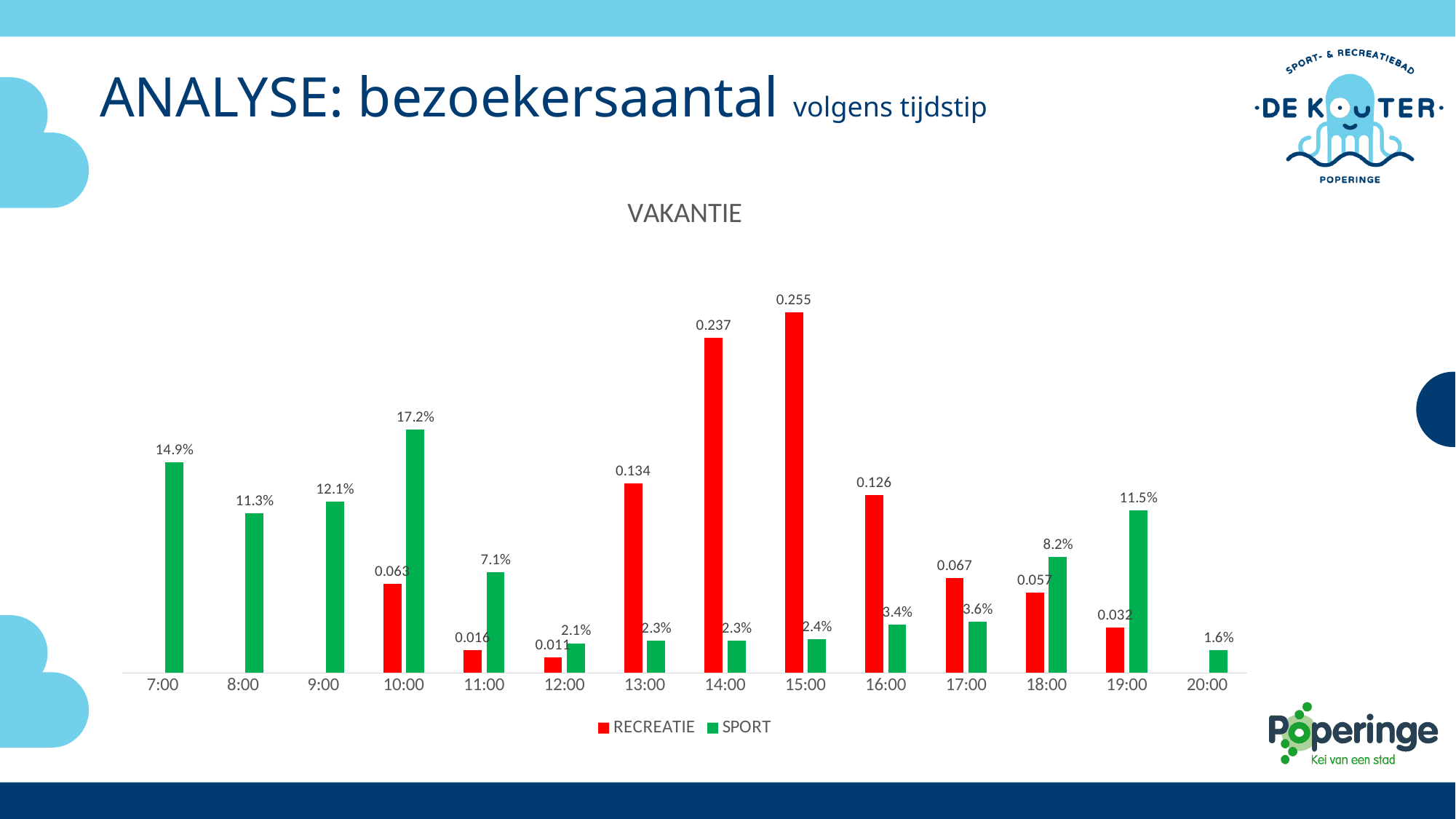
At which time is the RECREATIE value highest? 15:00 What is the SPORT value at 20:00? 1.6% What is the difference between the SPORT values at 10:00 and 7:00? 2.3 percentage points Which is larger: the SPORT value at 9:00 or at 8:00? 9:00 How many time categories are shown on the x axis? 14 At which time is the SPORT value highest? 10:00 What is the RECREATIE value at 14:00? 0.237 What is the difference between the RECREATIE values at 15:00 and 14:00? 0.018 At which time is the SPORT value lowest? 20:00 How many series does the legend list? 2 What type of chart is shown on the slide? Bar chart What is the SPORT value at 10:00? 17.2%